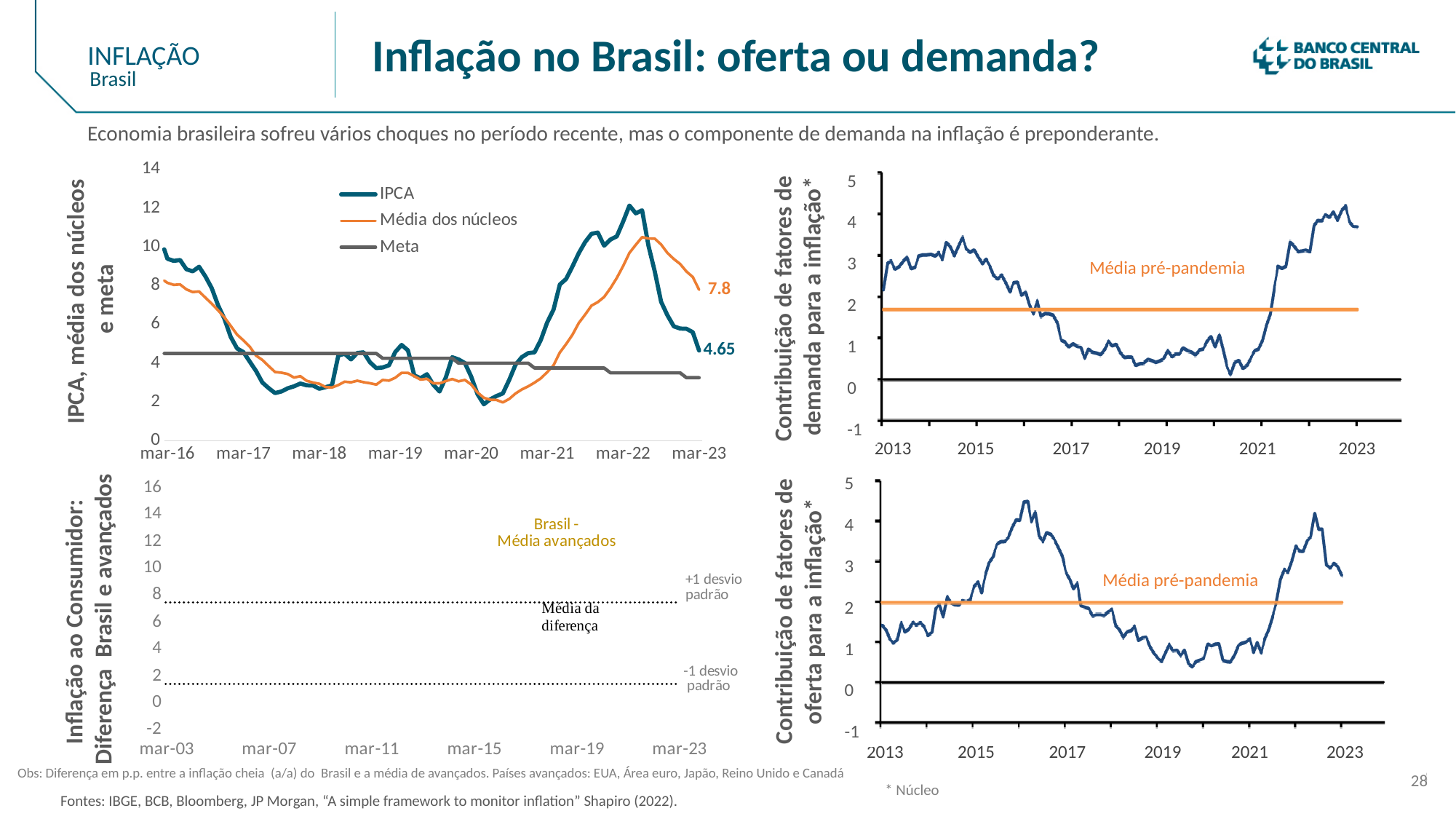
In the top-left chart (IPCA, média dos núcleos e meta), how many series does the legend list? 3 In the top-left chart (IPCA, média dos núcleos e meta), which series has the higher labelled final value, IPCA or Média dos núcleos? Média dos núcleos In the top-left chart (IPCA, média dos núcleos e meta), what is the labelled final value of the Média dos núcleos series? 7.8 In the bottom-right chart (Contribuição de fatores de oferta para a inflação), is the peak around 2016 greater or less than 4? greater What kind of chart is the top-left chart (IPCA, média dos núcleos e meta)? line chart In the top-left chart (IPCA, média dos núcleos e meta), is the Meta series at mar-23 greater or less than 4? less In the top-right chart (Contribuição de fatores de demanda para a inflação), is the value at 2023 greater or less than 3? greater In the top-left chart (IPCA, média dos núcleos e meta), what is the labelled final value of the IPCA series? 4.65 In the top-left chart (IPCA, média dos núcleos e meta), what is the difference between the labelled final values of Média dos núcleos and IPCA? 3.15 In the bottom-right chart (Contribuição de fatores de oferta para a inflação), what is the label of the horizontal orange line? Média pré-pandemia